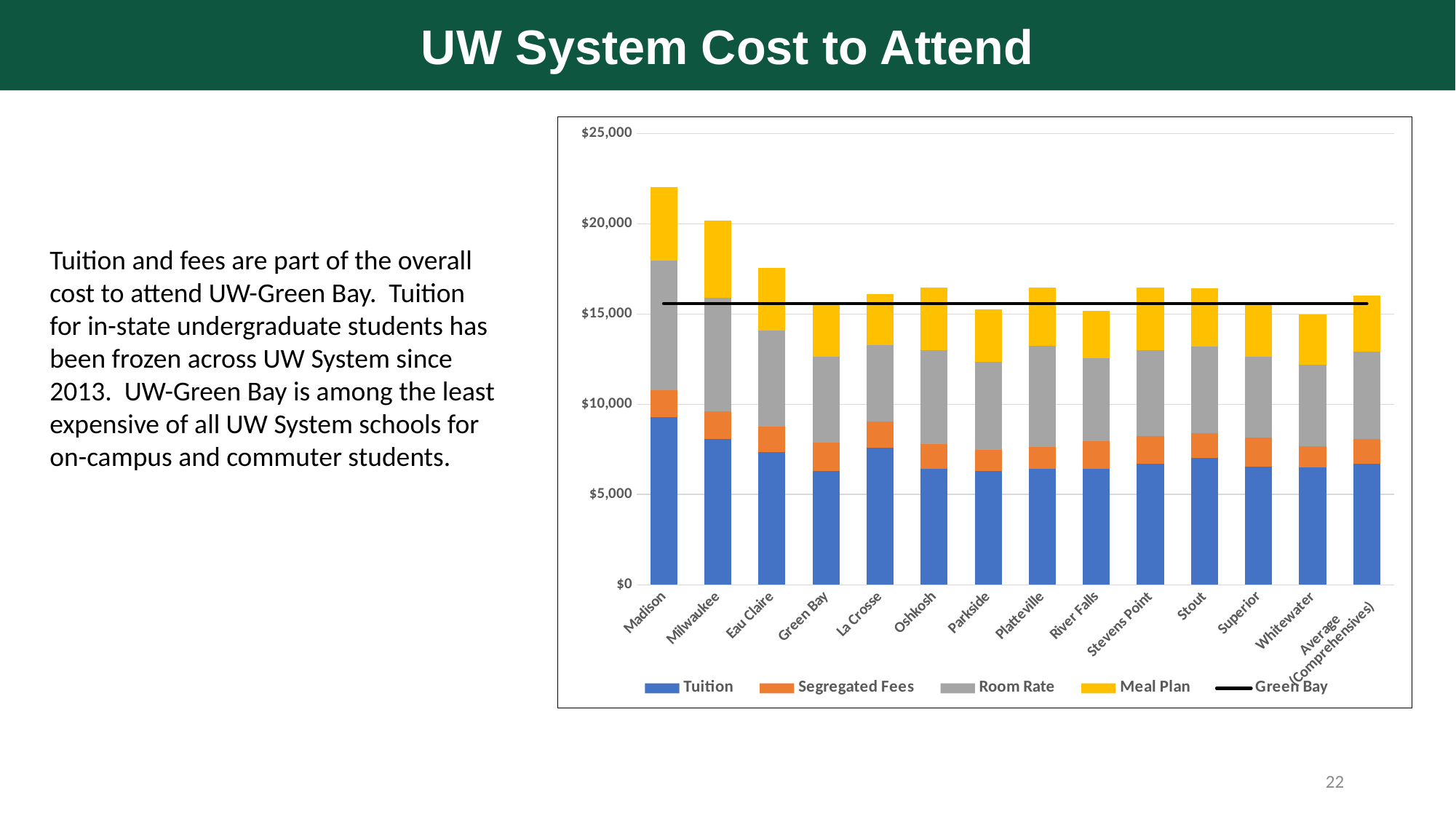
Is the total cost to attend for Madison greater or less than $20,000? greater Which campus has the tallest Tuition segment in the chart? Madison Which has a larger Tuition segment, Madison or Green Bay? Madison Is the Tuition value for Madison greater or less than $5,000? greater How many campus categories are shown along the x axis of the chart? 14 Is the total cost to attend for Eau Claire greater or less than $15,000? greater Which has a larger total cost to attend, Madison or Milwaukee? Madison What kind of chart is shown on the slide? Stacked bar chart How many series does the chart's legend list? 5 Which campus has the highest total cost to attend in the chart? Madison What is the name of the series drawn as a horizontal black line across the chart? Green Bay